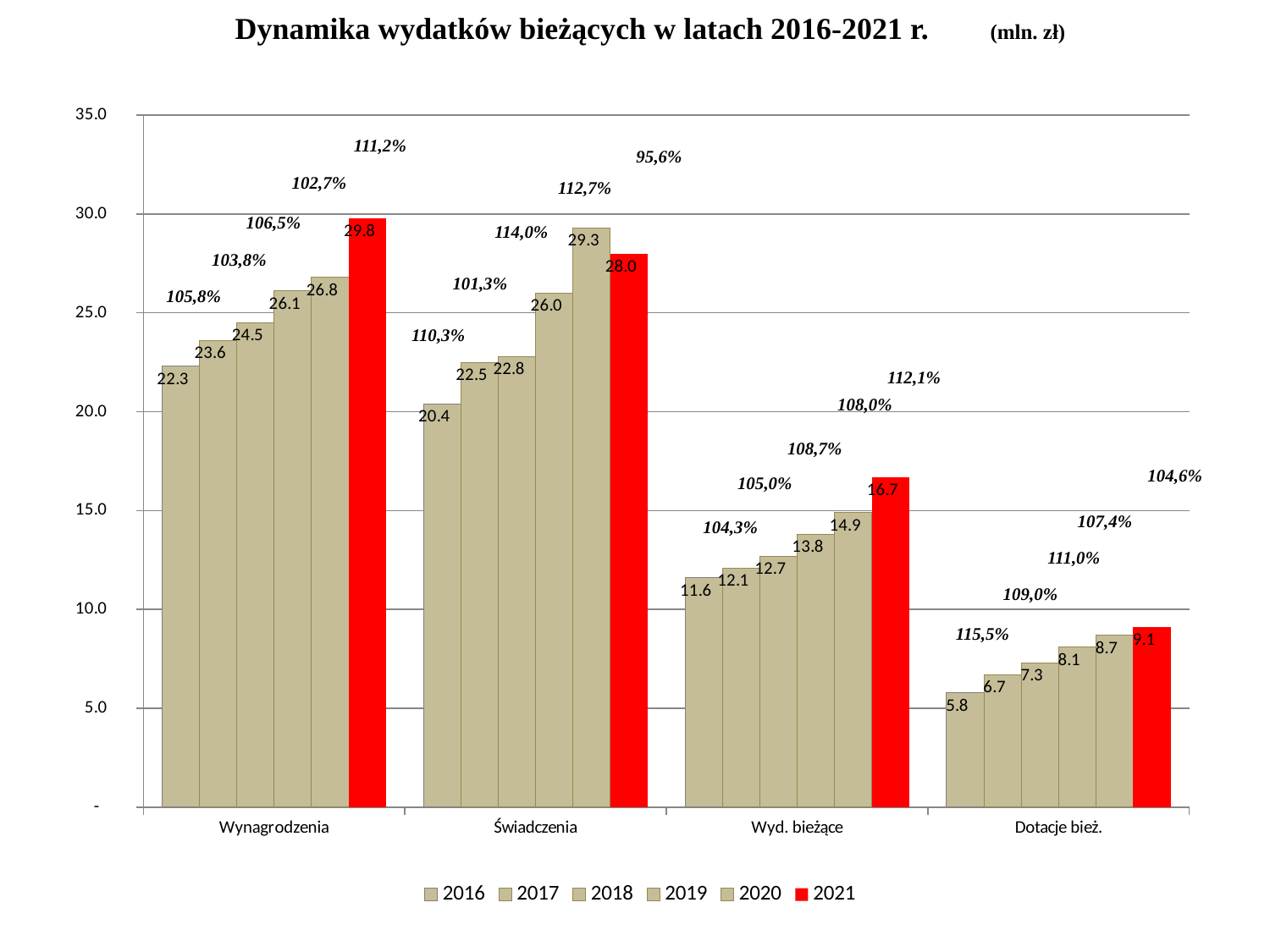
How many series does the legend list? 6 Which is larger: Wynagrodzenia in 2021 or Świadczenia in 2021? Wynagrodzenia in 2021 What is the value for Dotacje bież. in 2019? 8.1 Do the values for Dotacje bież. rise or fall from 2016 to 2021? rise Is the value for Wyd. bieżące in 2020 greater or less than 15.0? less What is the value for Wynagrodzenia in 2021? 29.8 What is the difference between the 2021 and 2016 values for Wyd. bieżące? 5.1 What is the value for Świadczenia in 2016? 20.4 Which category has the lowest value in 2021? Dotacje bież. How many categories are shown on the x axis? 4 What kind of chart is shown on the slide? bar chart Which year has the highest value for Świadczenia? 2020